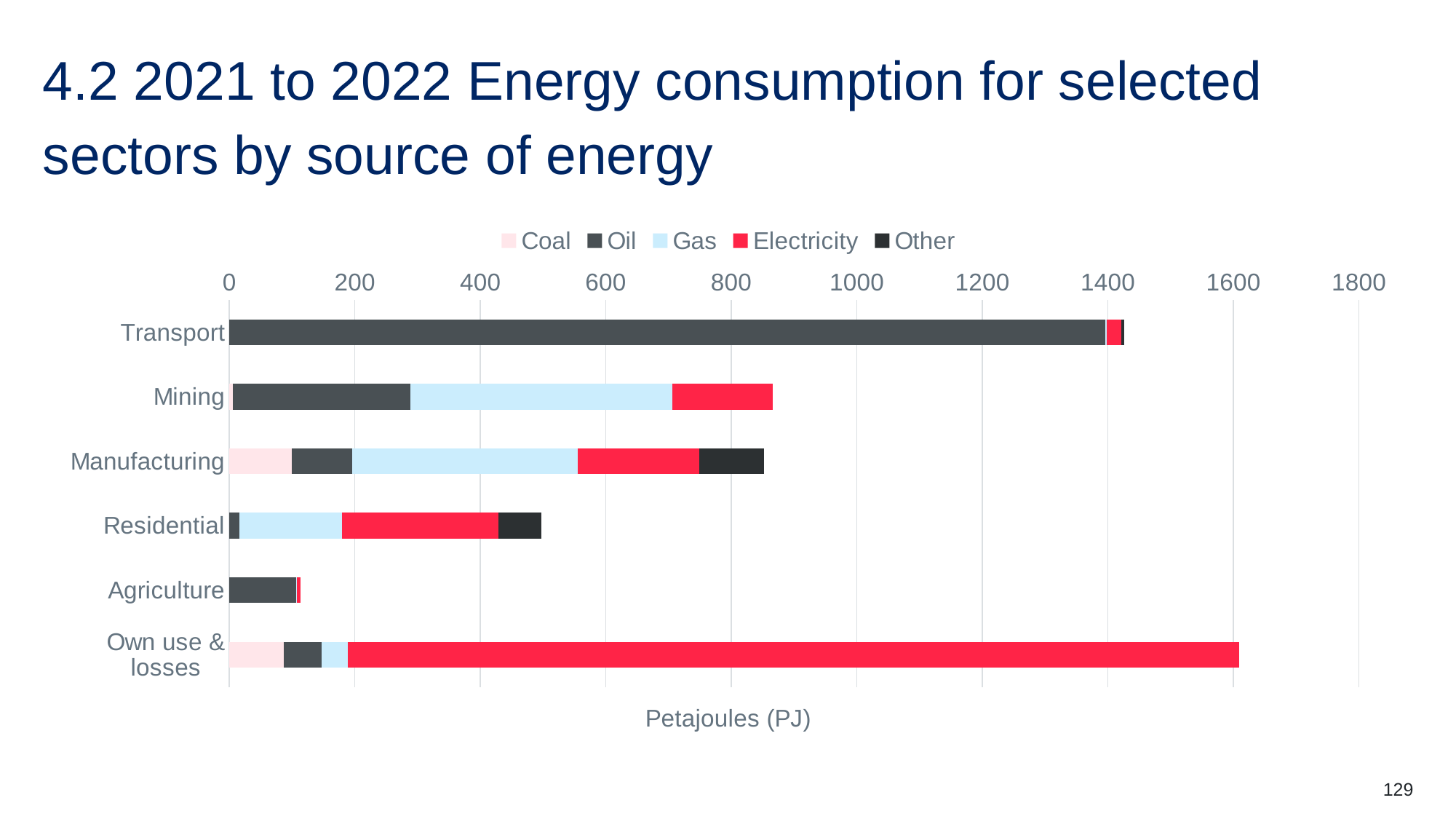
Which sector has the highest total energy consumption? Own use & losses What kind of chart is shown on the slide? Stacked bar chart How many sectors (categories) are plotted on the chart? 6 Is the total value for Mining greater or less than 800? greater Is the total value for Transport greater or less than 1200? greater Is the total value for Residential greater or less than 600? less How many energy sources does the legend list? 5 Which sector has the lowest total energy consumption? Agriculture What is the label of the horizontal axis? Petajoules (PJ) Which sector has the largest Oil segment? Transport Which has the larger total energy consumption, Transport or Mining? Transport